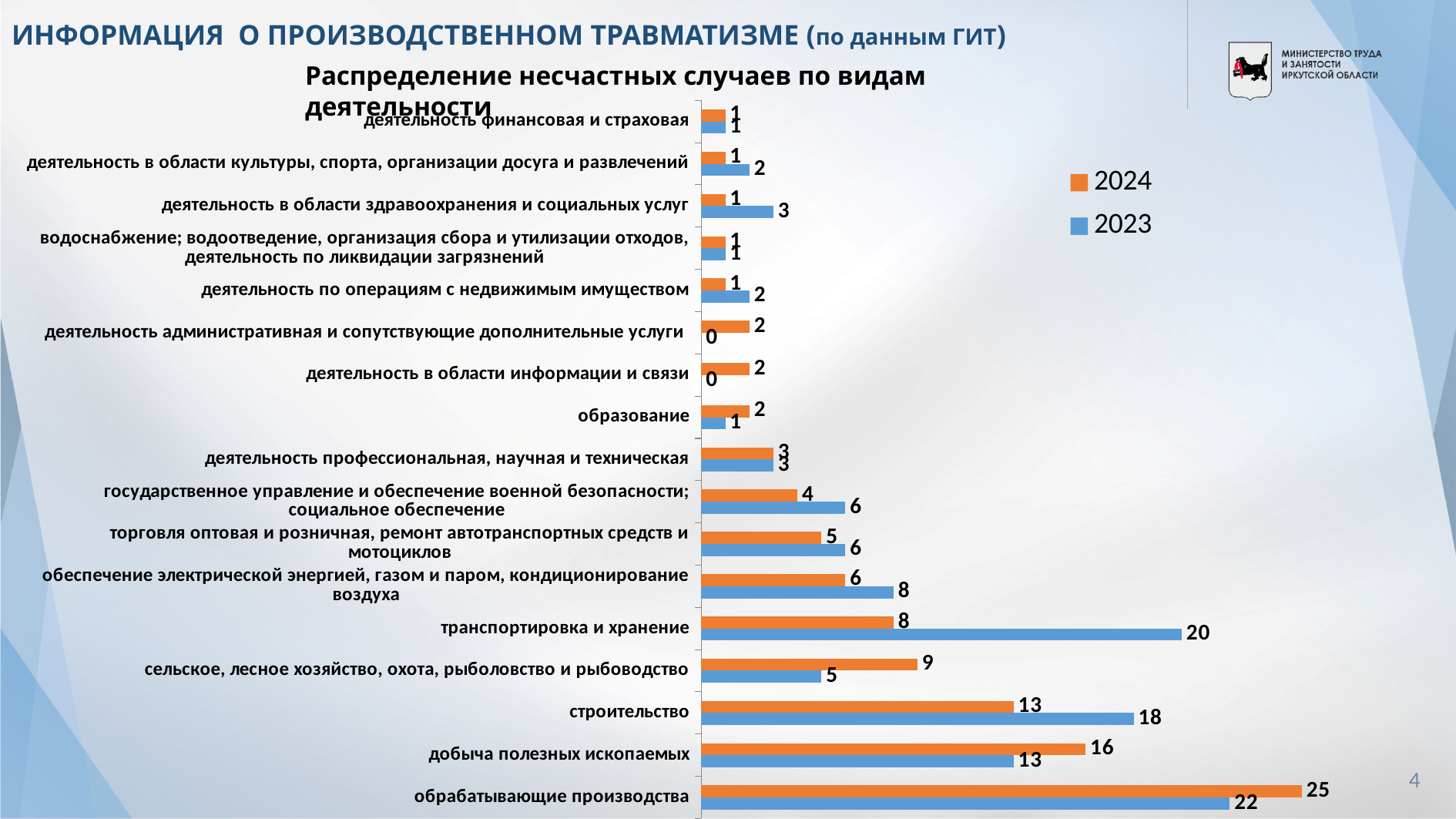
How many series does the legend list? 2 What is the difference between the 2024 and 2023 values for добыча полезных ископаемых? 3 What type of chart is shown on the slide? bar chart For строительство, which year has the larger value, 2024 or 2023? 2023 What is the difference between the 2023 and 2024 values for транспортировка и хранение? 12 For сельское, лесное хозяйство, охота, рыболовство и рыбоводство, which year has the larger value, 2024 or 2023? 2024 What is the 2023 value for транспортировка и хранение? 20 What is the 2024 value for обрабатывающие производства? 25 Which category has the highest 2024 value? обрабатывающие производства What is the 2024 value for строительство? 13 Which category has the highest 2023 value? обрабатывающие производства How many categories are shown on the chart? 17